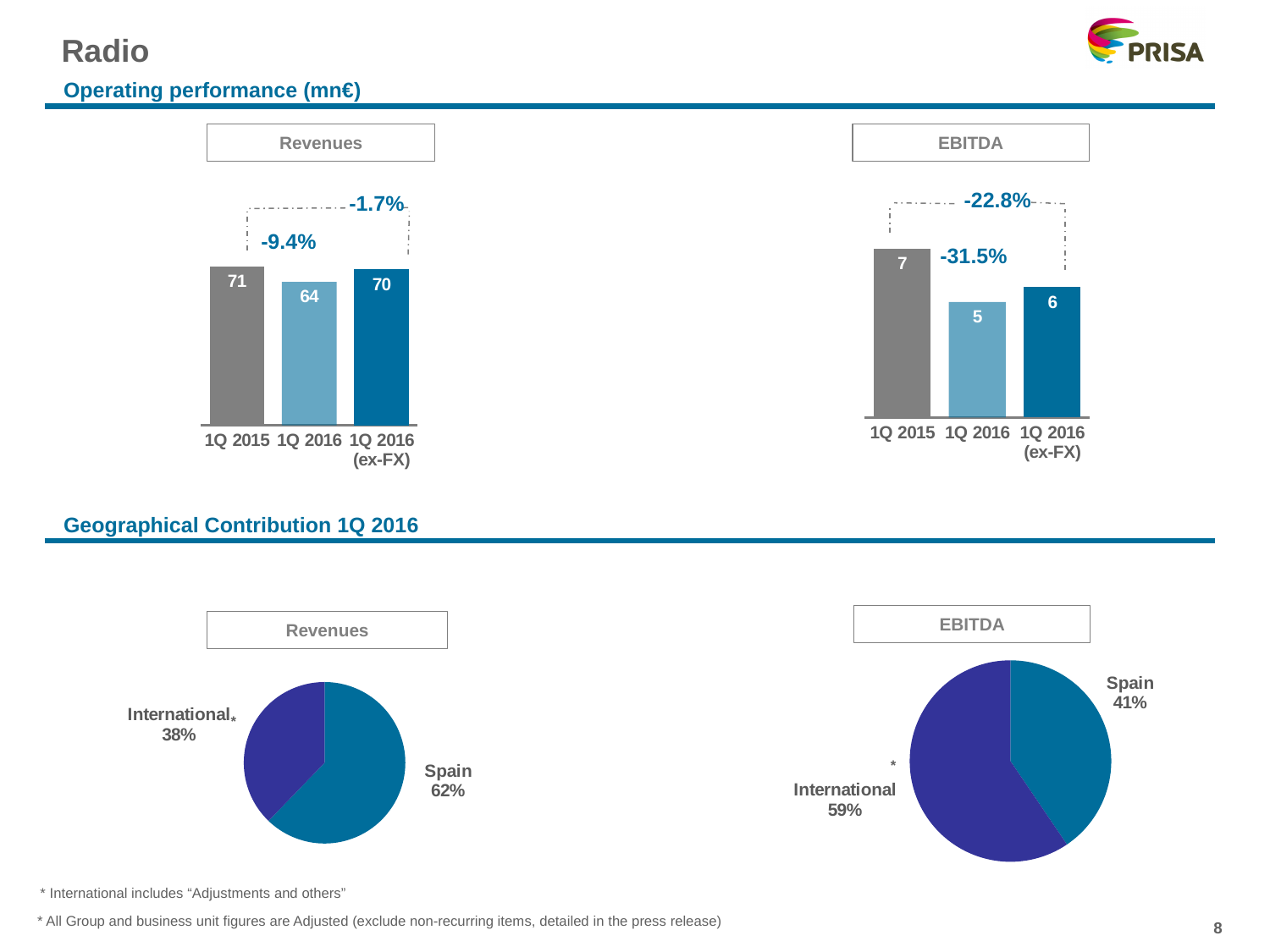
In the EBITDA pie chart under Geographical Contribution 1Q 2016, what share does International have? 59% In the Revenues bar chart under Operating performance, what is the value for 1Q 2016? 64 In the Revenues bar chart under Operating performance, what is the difference between the 1Q 2015 and 1Q 2016 values? 7 In the Revenues bar chart under Operating performance, which period has the highest value? 1Q 2015 In the Revenues pie chart under Geographical Contribution 1Q 2016, what share does Spain have? 62% What kind of chart is the Revenues chart under Geographical Contribution 1Q 2016? Pie chart In the Revenues bar chart under Operating performance, what percentage change is shown between 1Q 2015 and 1Q 2016 (ex-FX)? -1.7% How many bars are in the Revenues bar chart under Operating performance? 3 In the Revenues bar chart under Operating performance, what is the value for 1Q 2015? 71 In the EBITDA bar chart under Operating performance, which is larger, 1Q 2015 or 1Q 2016 (ex-FX)? 1Q 2015 In the EBITDA bar chart under Operating performance, what is the value for 1Q 2016 (ex-FX)? 6 In the EBITDA bar chart under Operating performance, which period has the lowest value? 1Q 2016